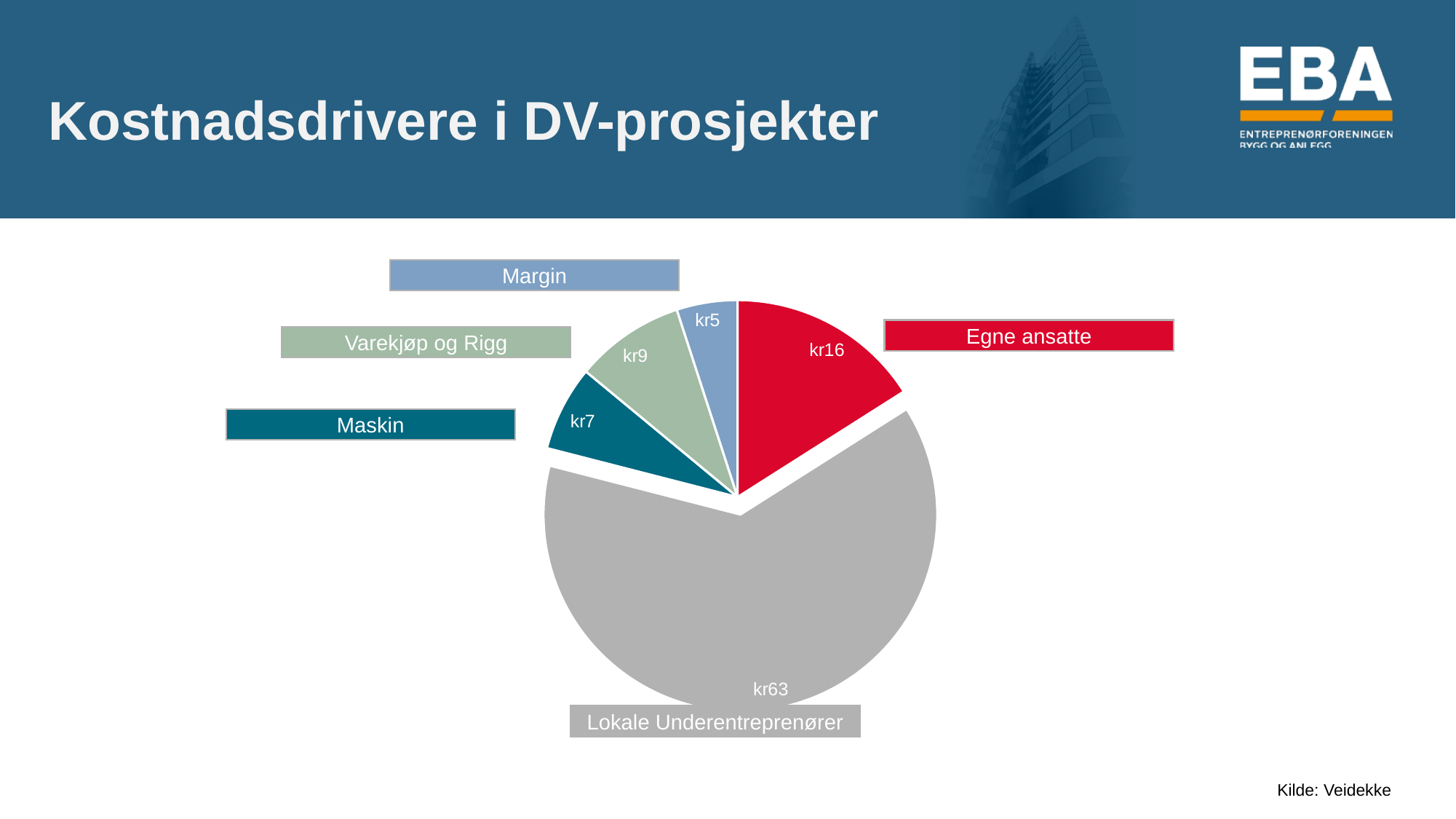
How many slices does the pie chart have? 5 What is the value for Lokale Underentreprenører? kr63 Which is larger, the value for Varekjøp og Rigg or the value for Maskin? Varekjøp og Rigg What is the difference between the values for Egne ansatte and Maskin? kr9 What is the value for Egne ansatte? kr16 What kind of chart is shown on the slide? Pie chart What is the value for Margin? kr5 What is the value for Varekjøp og Rigg? kr9 Which category has the smallest slice of the pie? Margin What share of the pie does Lokale Underentreprenører represent? 63% What is the value for Maskin? kr7 Which category has the largest slice of the pie? Lokale Underentreprenører